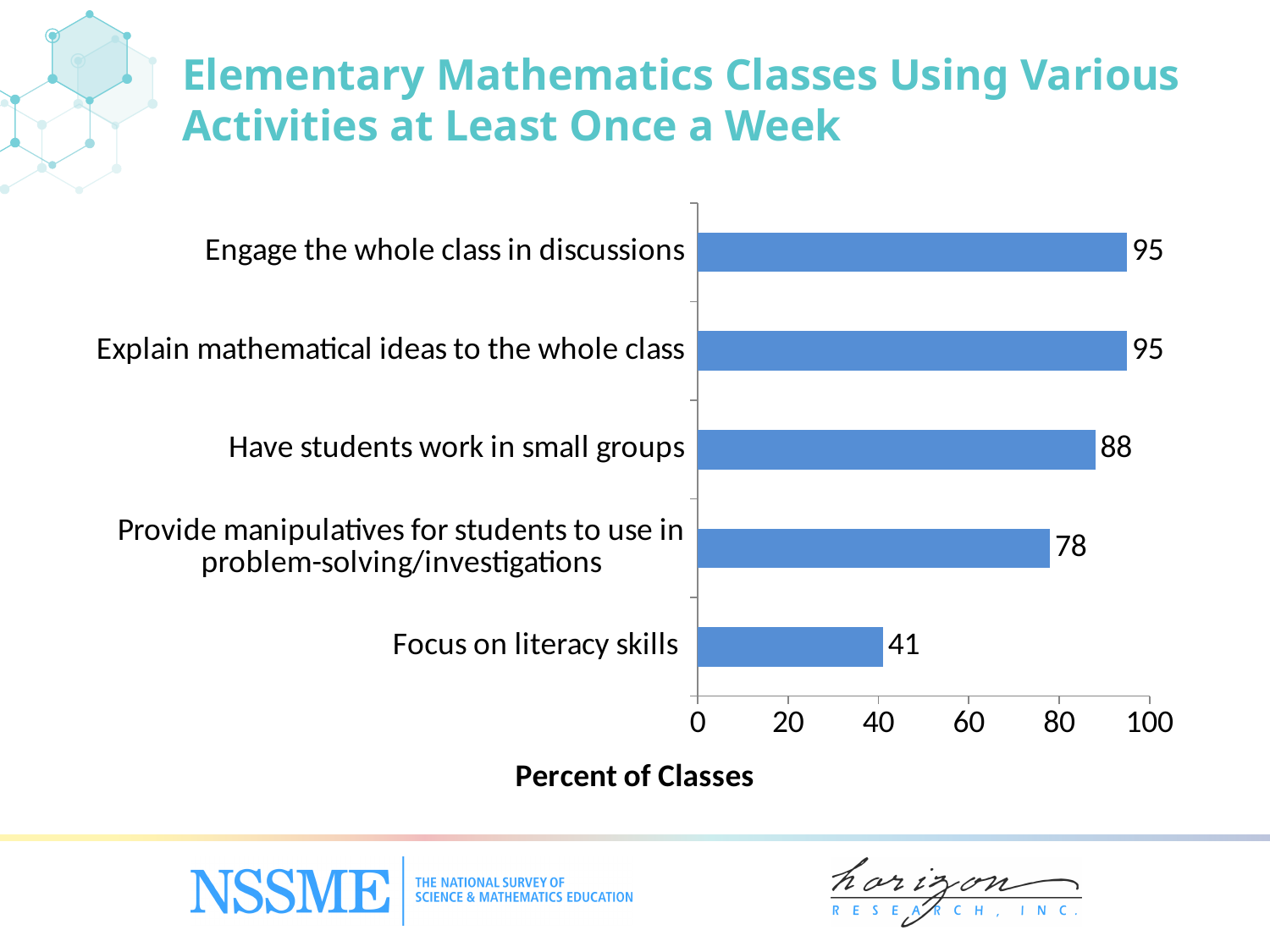
What percent of classes have students work in small groups at least once a week? 88 What is the value for 'Focus on literacy skills'? 41 What is the difference between the values for 'Explain mathematical ideas to the whole class' and 'Provide manipulatives for students to use in problem-solving/investigations'? 17 What is the label of the horizontal axis? Percent of Classes How many activities are shown in the chart? 5 What kind of chart is shown on the slide? bar chart Which is larger: the value for 'Have students work in small groups' or the value for 'Provide manipulatives for students to use in problem-solving/investigations'? Have students work in small groups What is the difference between the values for 'Have students work in small groups' and 'Focus on literacy skills'? 47 Which activity has the lowest percent of classes? Focus on literacy skills What is the value for 'Engage the whole class in discussions'? 95 What is the value for 'Provide manipulatives for students to use in problem-solving/investigations'? 78 Is the value for 'Focus on literacy skills' greater or less than 60? less